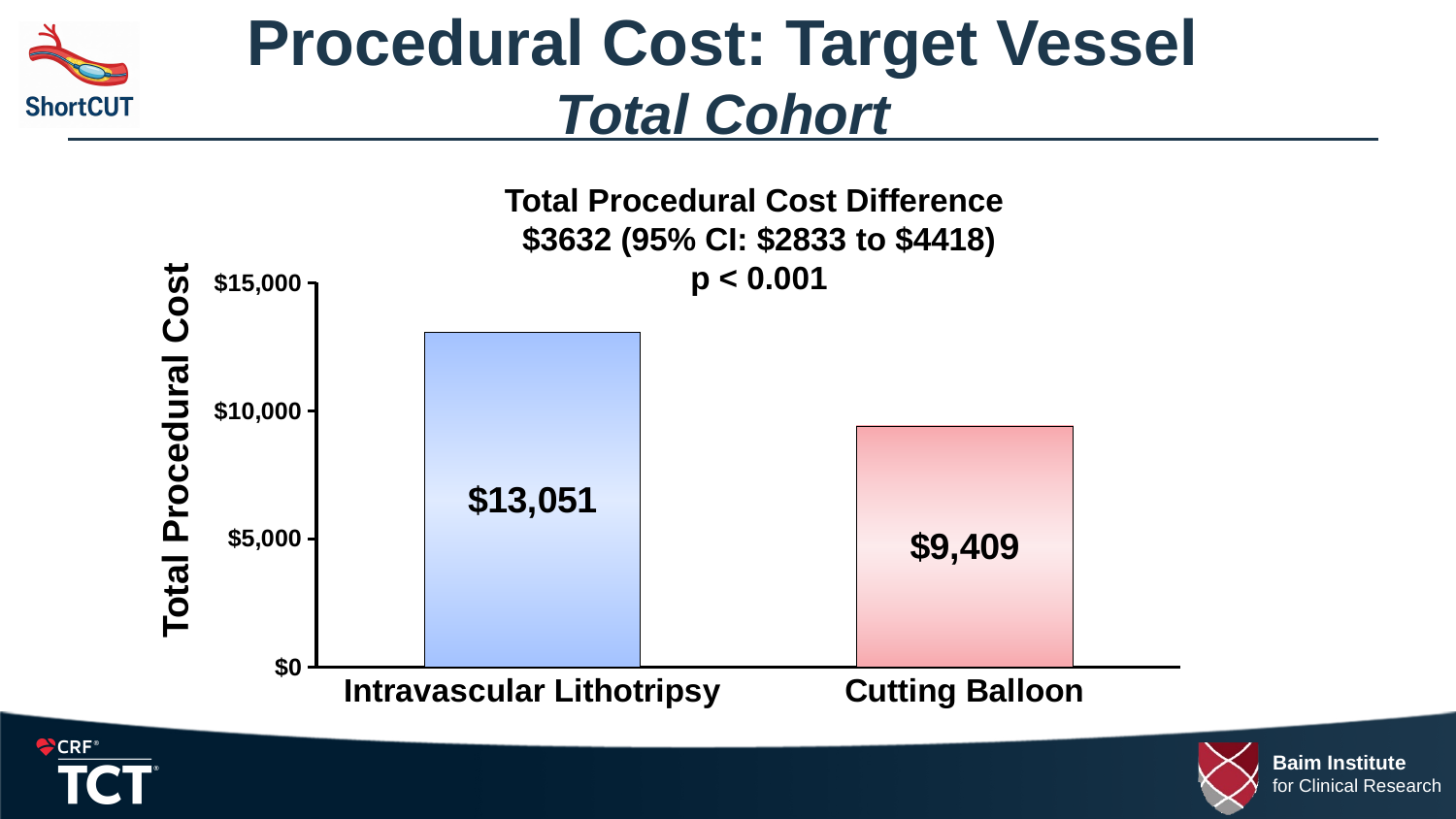
Is the value for Intravascular Lithotripsy larger or smaller than the value for Cutting Balloon? larger What is the total procedural cost for Intravascular Lithotripsy? $13,051 What is the p-value stated above the chart for the total procedural cost difference? p < 0.001 What is the total procedural cost for Cutting Balloon? $9,409 Is the total procedural cost for Cutting Balloon greater or less than $10,000? less Which category has the higher total procedural cost? Intravascular Lithotripsy What kind of chart is shown on the slide? bar chart What is the difference in total procedural cost between Intravascular Lithotripsy and Cutting Balloon? $3,642 How many categories are shown on the x axis of the chart? 2 Which category has the lower total procedural cost? Cutting Balloon What is the label of the y axis of the chart? Total Procedural Cost Is the total procedural cost for Intravascular Lithotripsy greater or less than $10,000? greater